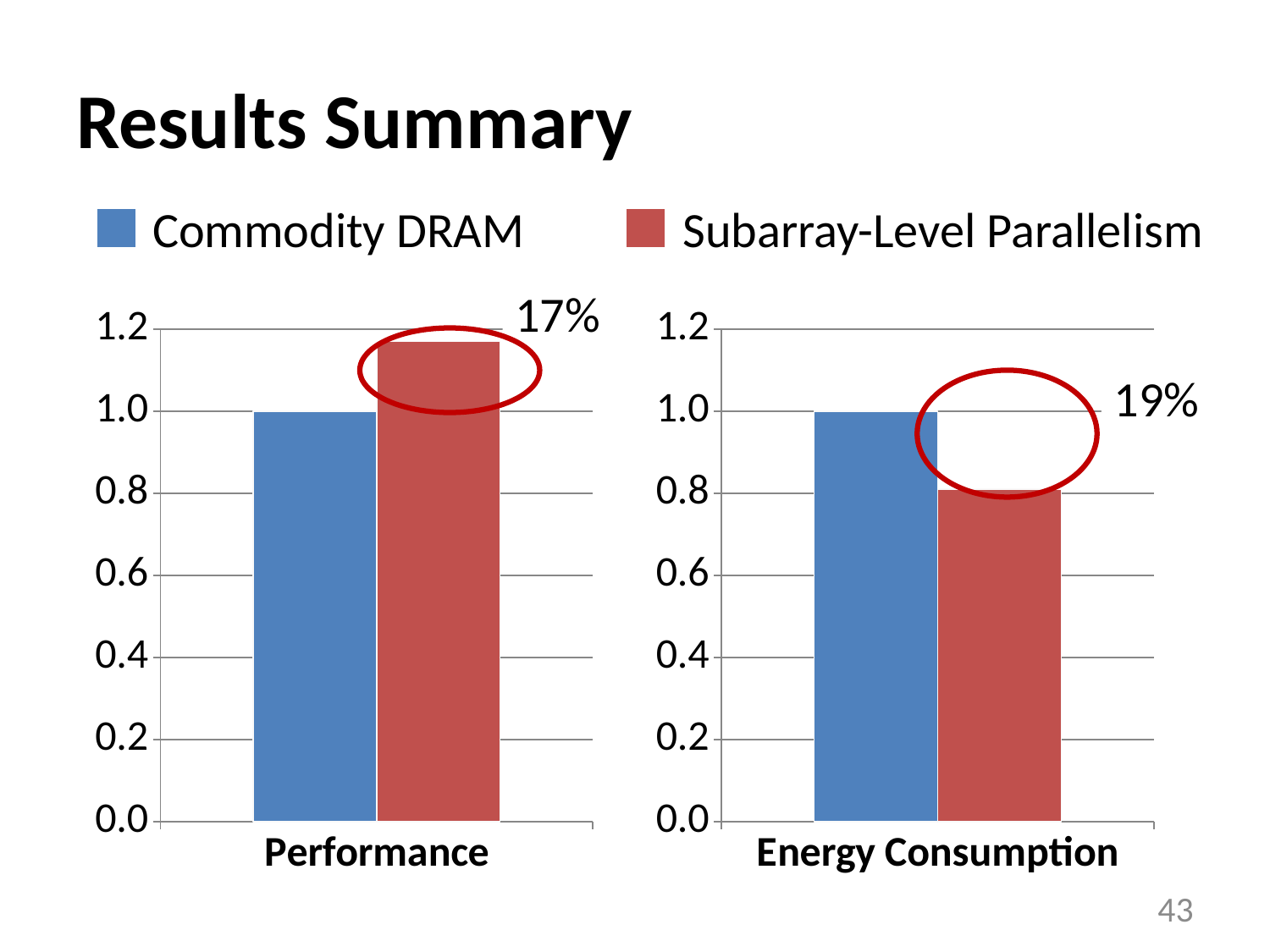
In the Energy Consumption chart, which series has the lower bar? Subarray-Level Parallelism How many bars are in the Energy Consumption chart? 2 In the Performance chart, is the value for Subarray-Level Parallelism greater or less than 1.0? greater What kind of chart is the Performance chart? bar chart How many series does the legend list? 2 In the Performance chart, what is the value for Commodity DRAM? 1.0 What percentage is annotated next to the circled bar in the Performance chart? 17% In the Energy Consumption chart, is the value for Subarray-Level Parallelism greater or less than 1.0? less In the Performance chart, which series has the higher bar? Subarray-Level Parallelism What percentage is annotated next to the circled area in the Energy Consumption chart? 19% In the Energy Consumption chart, is the value for Subarray-Level Parallelism greater or less than 0.6? greater In the Energy Consumption chart, what is the value for Commodity DRAM? 1.0